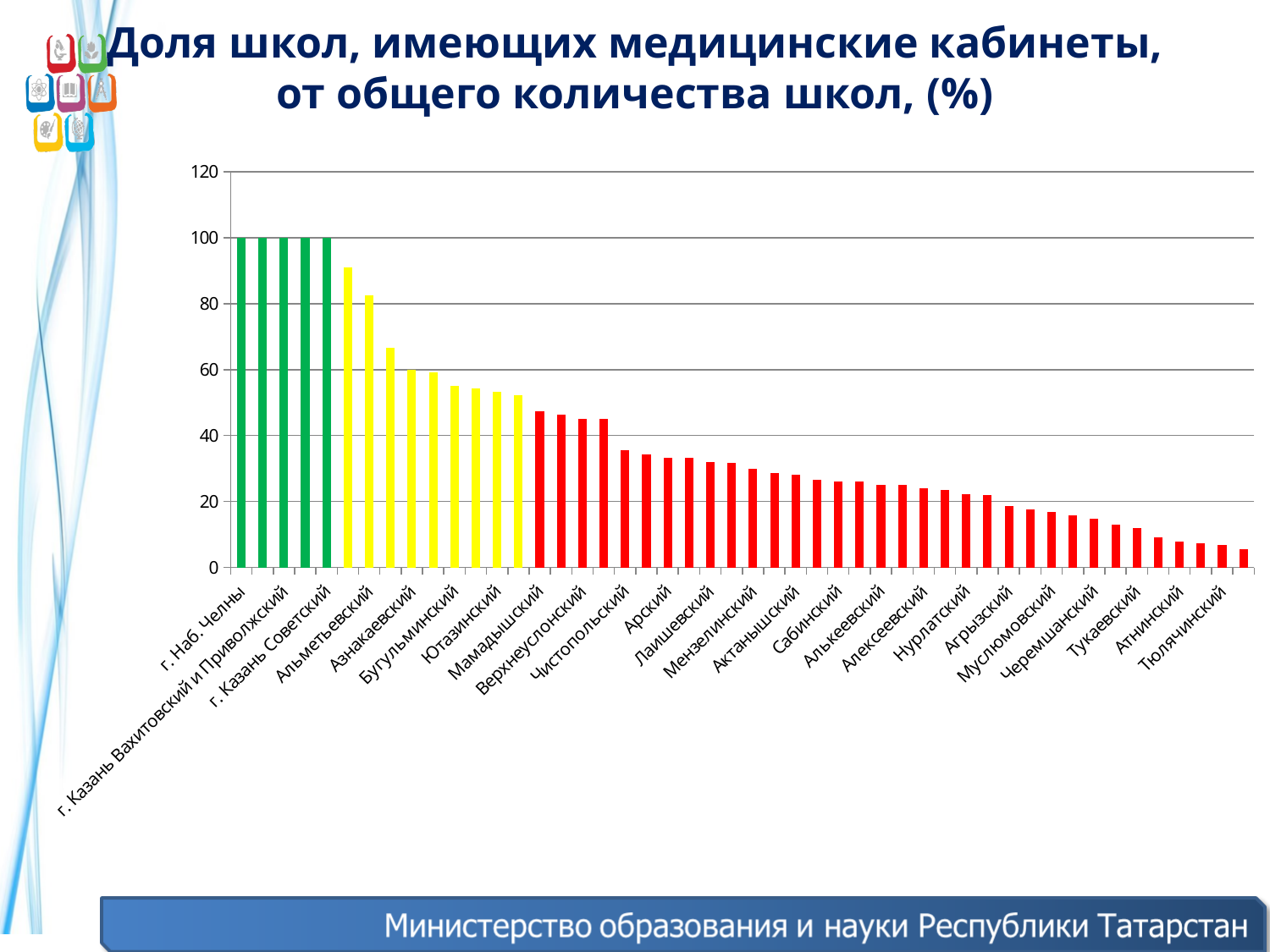
Do the values rise or fall from left to right along the x axis? fall Is the value for Арский greater or less than 40? less Is the value for Мамадышский greater or less than 60? less Which is larger, the value for Альметьевский or the value for Атнинский? Альметьевский Is the value for Альметьевский greater or less than 60? greater What is the value for г. Казань Советский? 100 What is the value for г. Казань Вахитовский и Приволжский? 100 What colour are the bars with the highest values? green What kind of chart is shown on the slide? bar chart What is the value for г. Наб. Челны? 100